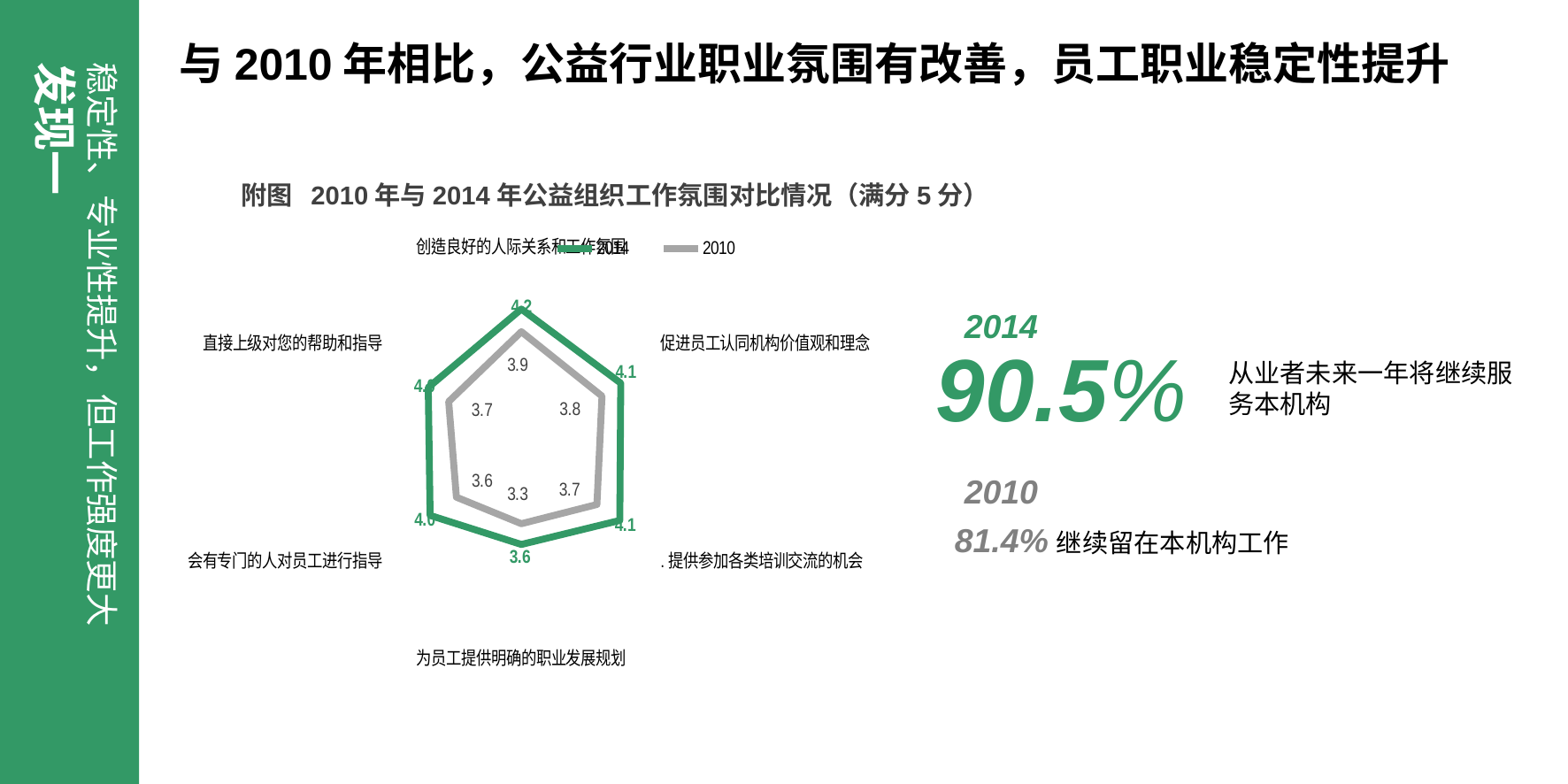
What is the 2014 value for 为员工提供明确的职业发展规划? 3.6 Which category has the lowest 2010 value? 为员工提供明确的职业发展规划 What kind of chart is shown on the slide? radar chart What is the difference between the 2014 and 2010 values for 提供参加各类培训交流的机会? 0.4 Which series has the larger value for 会有专门的人对员工进行指导, 2014 or 2010? 2014 How many categories (axes) does the radar chart have? 6 What is the 2010 value for 促进员工认同机构价值观和理念? 3.8 What is the 2014 value for 创造良好的人际关系和工作氛围? 4.2 Which category has the highest 2014 value? 创造良好的人际关系和工作氛围 What is the 2010 value for 创造良好的人际关系和工作氛围? 3.9 What is the 2010 value for 为员工提供明确的职业发展规划? 3.3 How many series does the chart legend list? 2